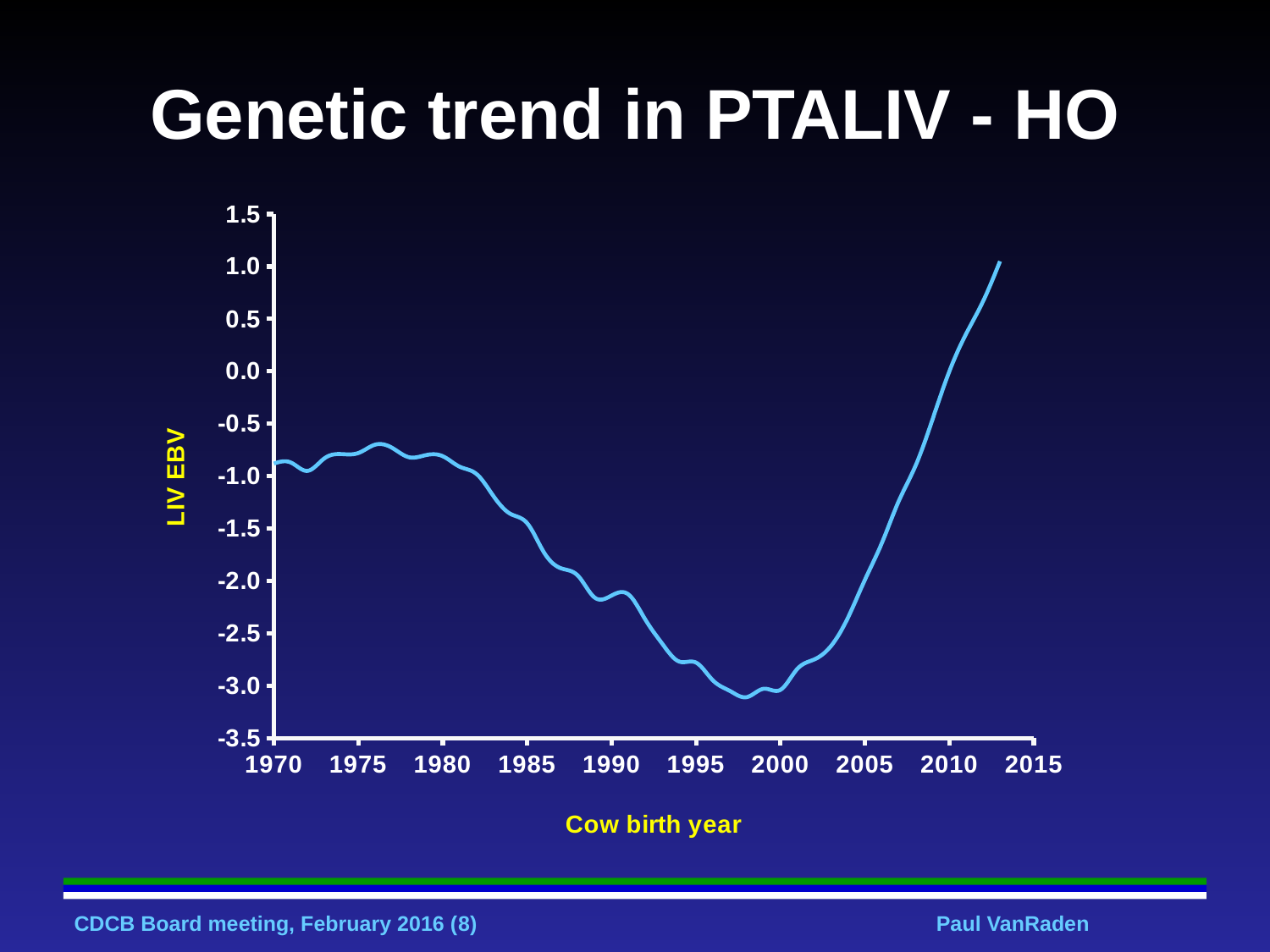
How many lines are plotted on the chart? 1 What is the title of the chart? Genetic trend in PTALIV - HO What kind of chart is shown on the slide? line chart Is the LIV EBV value for 1975 greater or less than -1.5? greater What is the label of the x axis? Cow birth year Does the LIV EBV value rise or fall between 2000 and 2010? rise Is the LIV EBV value for 1970 greater or less than -0.5? less Which is larger: the LIV EBV value for 1980 or for 1995? 1980 Does the LIV EBV value rise or fall between 1980 and 1995? fall Is the LIV EBV value for 1985 greater or less than -1.0? less